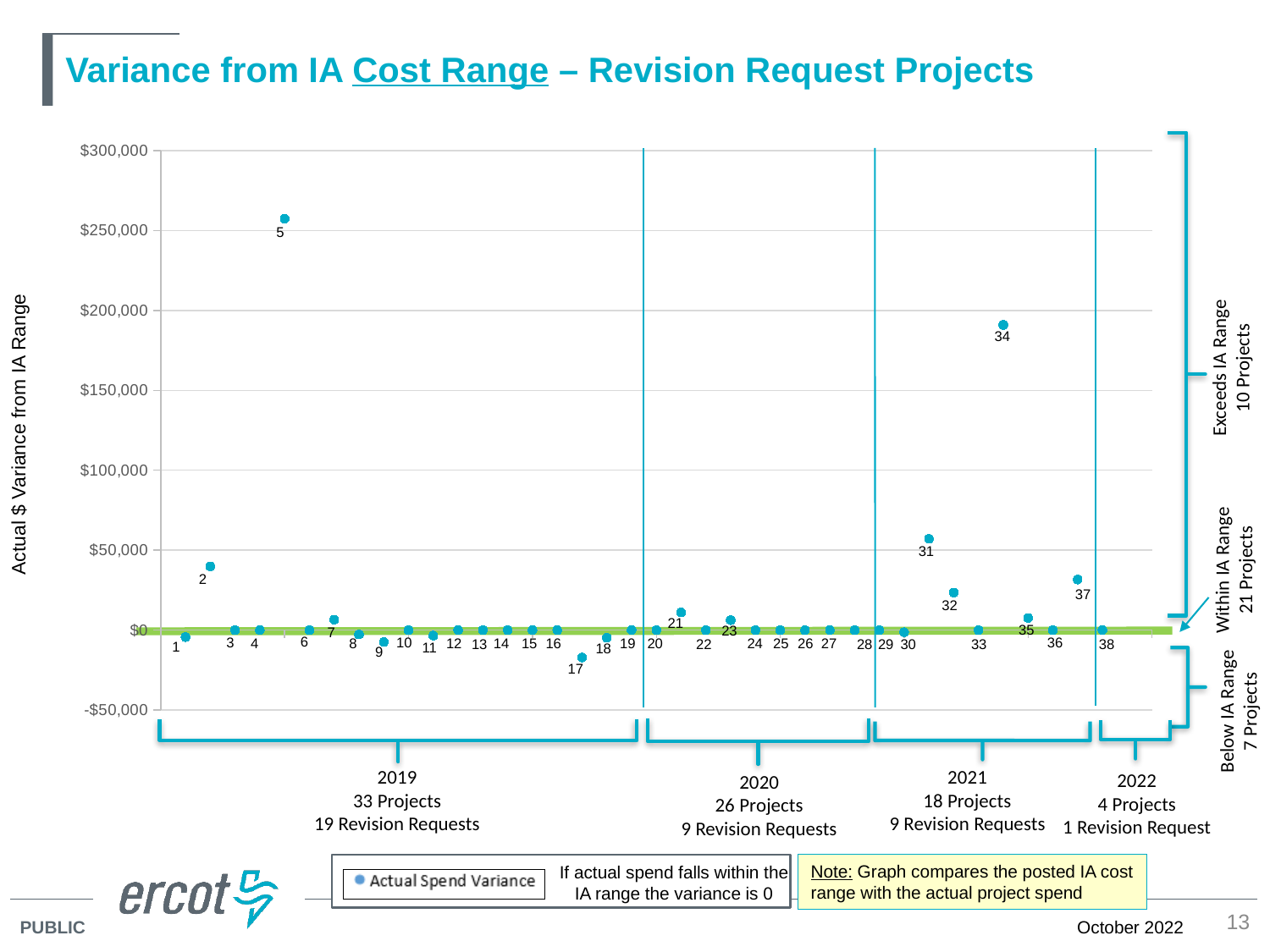
What is the single series listed in the chart legend? Actual Spend Variance Which numbered project has the highest actual $ variance from the IA range? 5 Which numbered project has the lowest (most negative) actual $ variance from the IA range? 17 Is the variance for project 2 greater or less than $50,000? less Is the variance for project 5 greater or less than $250,000? greater Is the variance for project 31 greater or less than $50,000? greater What kind of chart is shown on the slide? scatter chart Which has the larger variance, project 5 or project 34? project 5 Which has the larger variance, project 31 or project 2? project 31 How many numbered project points are plotted on the chart? 38